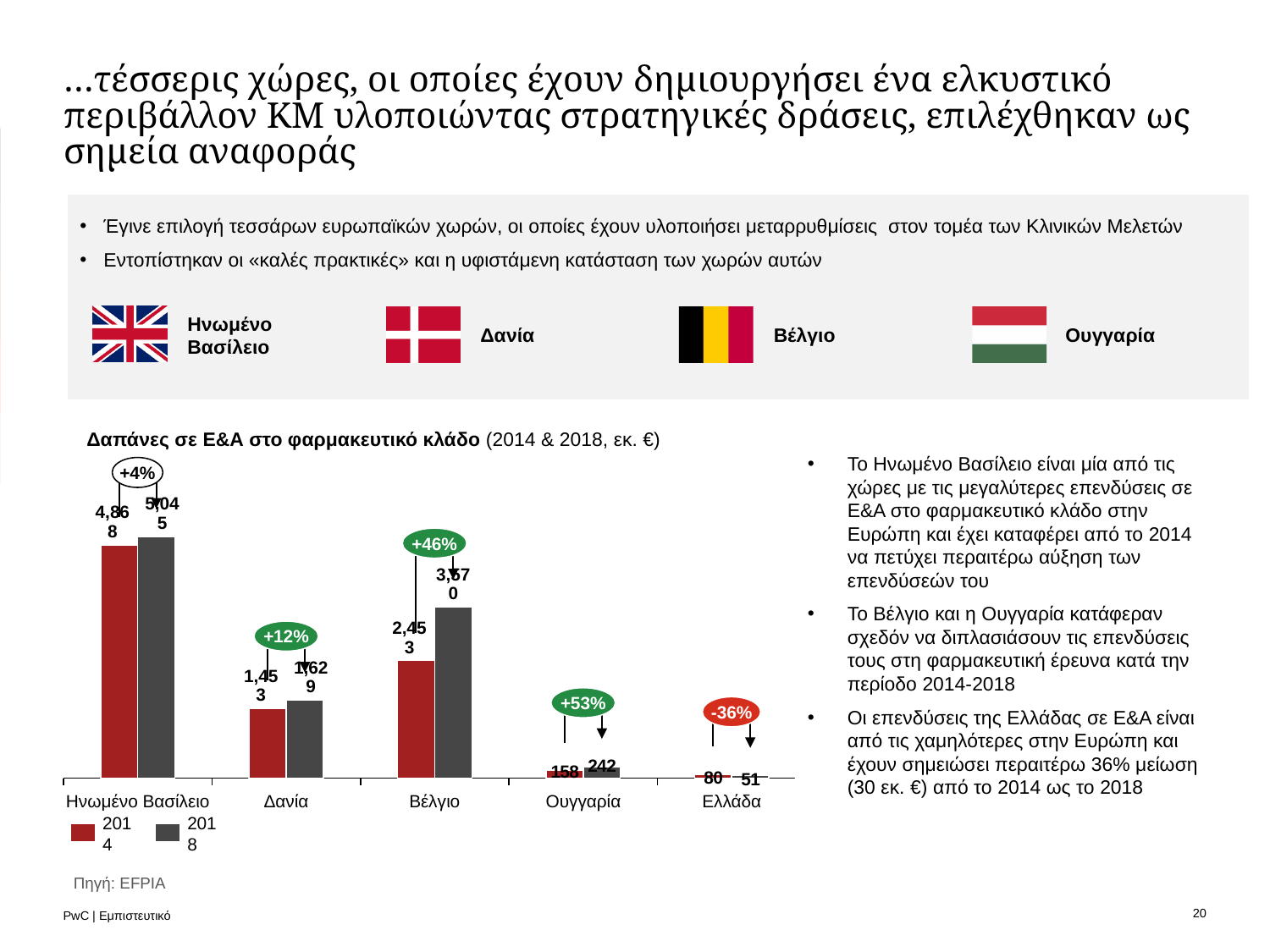
What kind of chart is shown on the slide? bar chart What is the difference between the 2018 and 2014 values for Ουγγαρία? 84 How many countries are shown on the x axis of the chart? 5 What is the 2018 value for Βέλγιο? 3,570 Which is larger for Ελλάδα, the 2014 value or the 2018 value? 2014 Which country has the highest 2018 value? Ηνωμένο Βασίλειο What is the 2018 value for Ελλάδα? 51 What is the 2014 value for Δανία? 1,453 Which country has the lowest 2014 value? Ελλάδα What percentage change is labelled above the bars for Βέλγιο? +46% How many series does the chart legend list? 2 What is the title of the chart? Δαπάνες σε Ε&Α στο φαρμακευτικό κλάδο (2014 & 2018, εκ. €)